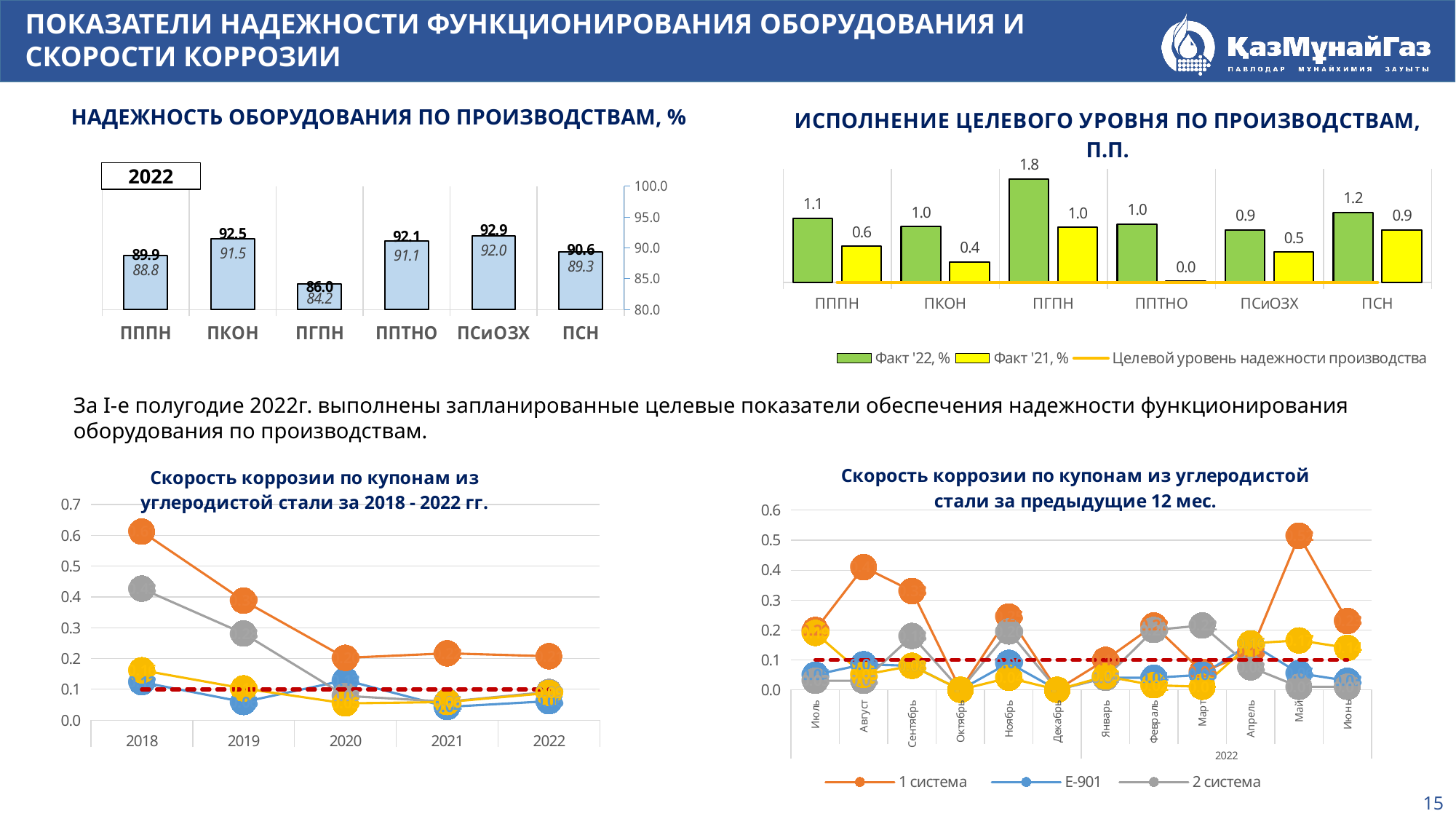
In the chart 'ИСПОЛНЕНИЕ ЦЕЛЕВОГО УРОВНЯ ПО ПРОИЗВОДСТВАМ, П.П.', what is the Факт '22 value for ПГПН? 1.8 In the chart 'ИСПОЛНЕНИЕ ЦЕЛЕВОГО УРОВНЯ ПО ПРОИЗВОДСТВАМ, П.П.', which category has the lowest Факт '21 value? ППТНО What kind of chart is 'Скорость коррозии по купонам из углеродистой стали за предыдущие 12 мес.'? line chart In the chart 'ИСПОЛНЕНИЕ ЦЕЛЕВОГО УРОВНЯ ПО ПРОИЗВОДСТВАМ, П.П.', which category has the highest Факт '22 value? ПГПН In the chart 'ИСПОЛНЕНИЕ ЦЕЛЕВОГО УРОВНЯ ПО ПРОИЗВОДСТВАМ, П.П.', which is larger for ПППН: Факт '22 or Факт '21? Факт '22 In the chart 'ИСПОЛНЕНИЕ ЦЕЛЕВОГО УРОВНЯ ПО ПРОИЗВОДСТВАМ, П.П.', what is the Факт '21 value for ПКОН? 0.4 How many categories are shown in the chart 'НАДЕЖНОСТЬ ОБОРУДОВАНИЯ ПО ПРОИЗВОДСТВАМ, %'? 6 In the chart 'НАДЕЖНОСТЬ ОБОРУДОВАНИЯ ПО ПРОИЗВОДСТВАМ, %', which production has the lowest reliability? ПГПН How many entries does the legend of the chart 'ИСПОЛНЕНИЕ ЦЕЛЕВОГО УРОВНЯ ПО ПРОИЗВОДСТВАМ, П.П.' list? 3 In the chart 'Скорость коррозии по купонам из углеродистой стали за предыдущие 12 мес.', is the value for '1 система' in Май greater or less than 0.4? greater In the chart 'НАДЕЖНОСТЬ ОБОРУДОВАНИЯ ПО ПРОИЗВОДСТВАМ, %', which production has the highest reliability? ПСиОЗХ In the chart 'ИСПОЛНЕНИЕ ЦЕЛЕВОГО УРОВНЯ ПО ПРОИЗВОДСТВАМ, П.П.', what is the difference between the Факт '22 and Факт '21 values for ПСН? 0.3